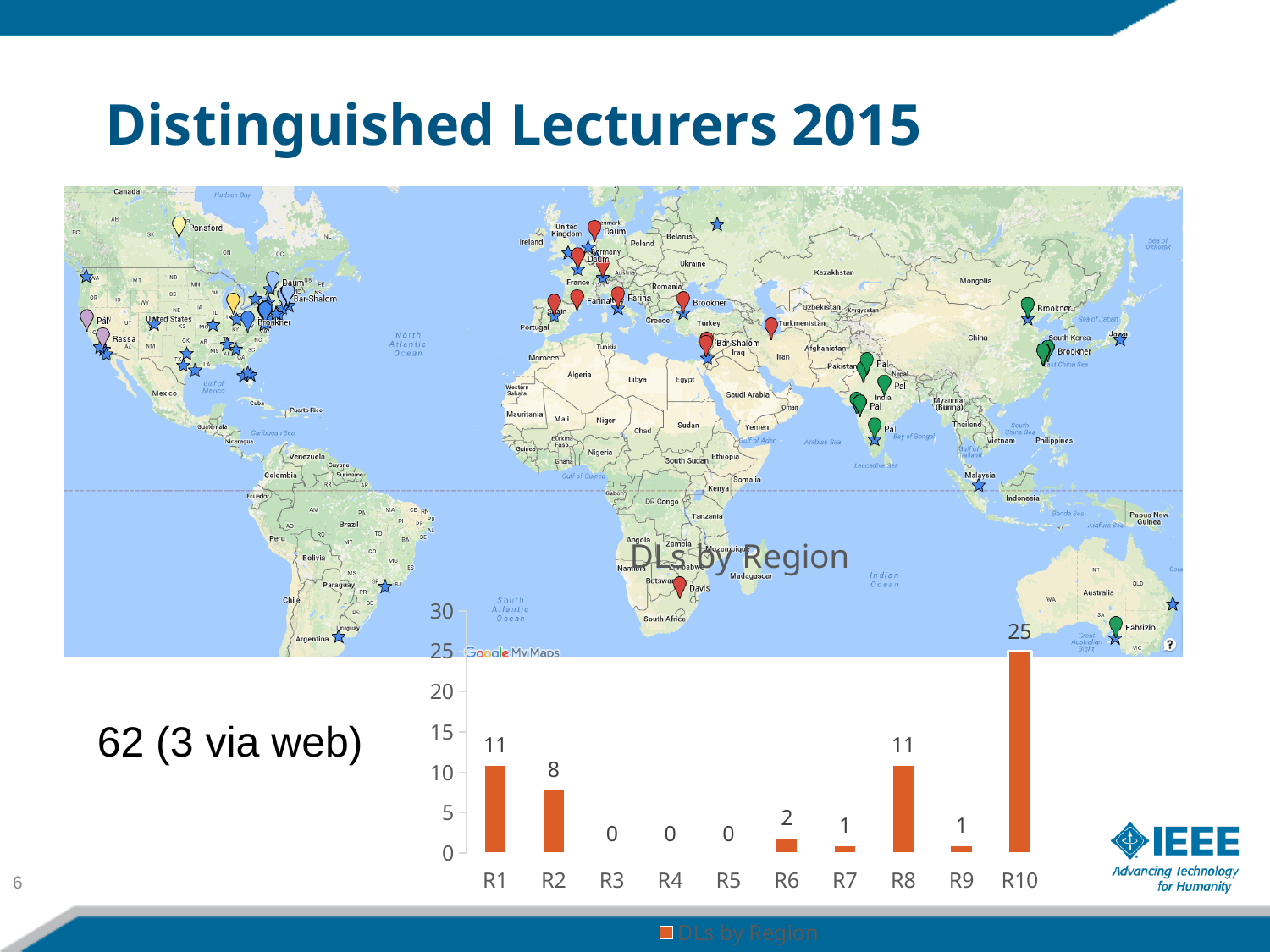
Which region has the highest value in the DLs by Region chart? R10 How many regions are shown on the x axis of the DLs by Region chart? 10 What is the value for R6 in the DLs by Region chart? 2 How many regions in the DLs by Region chart have a value of 0? 3 What is the value for R2 in the DLs by Region chart? 8 What is the difference between the values for R10 and R1 in the DLs by Region chart? 14 What kind of chart is the DLs by Region chart? bar chart Is the value for R10 in the DLs by Region chart greater or less than 20? greater What is the value for R10 in the DLs by Region chart? 25 Which is larger in the DLs by Region chart, the value for R2 or the value for R8? R8 What is the difference between the values for R1 and R2 in the DLs by Region chart? 3 How many series does the legend of the DLs by Region chart list? 1